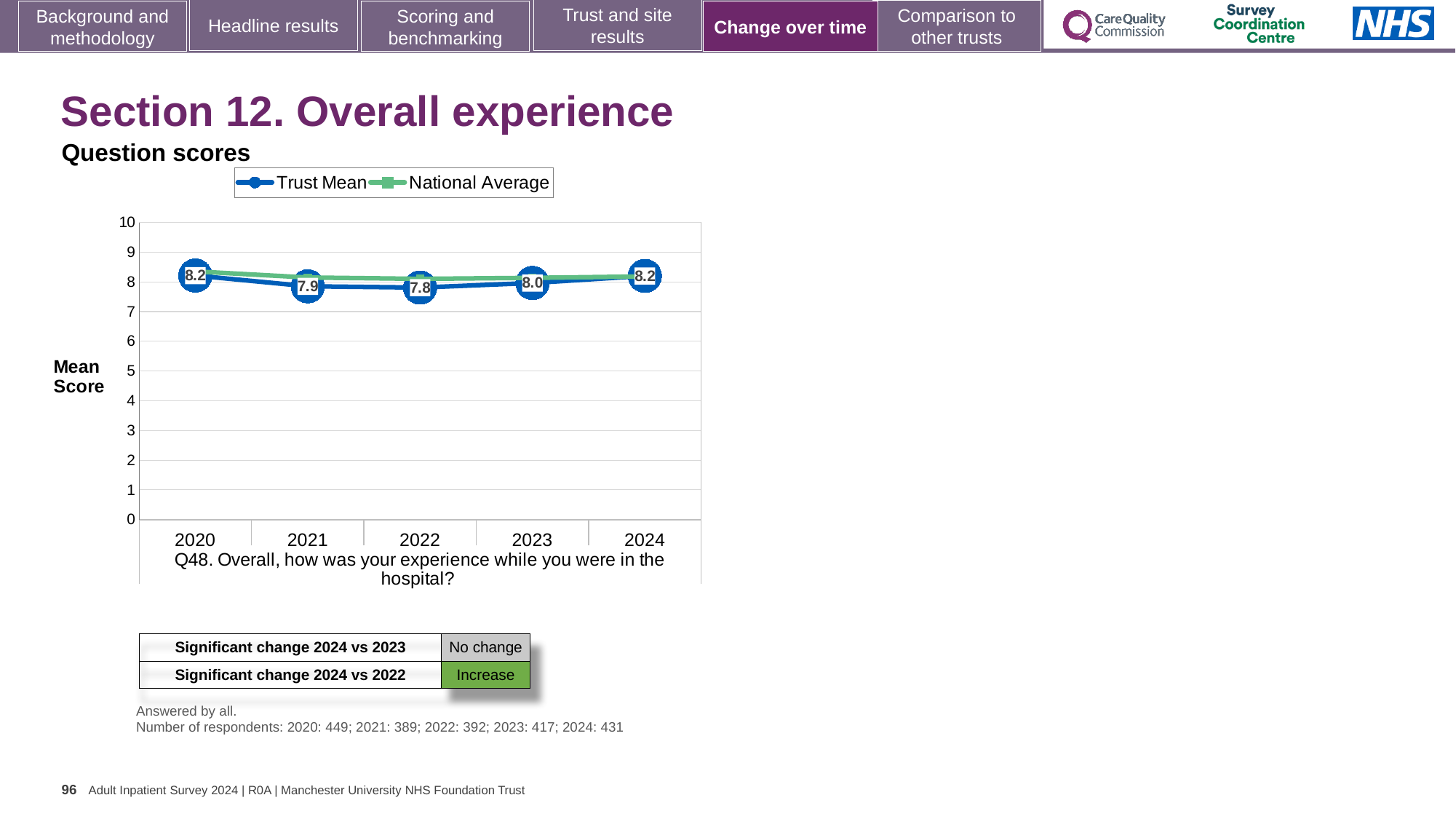
Which is larger, the Trust Mean score in 2021 or in 2023? 2023 Is the National Average value for 2020 greater or less than 8? greater What is the difference between the Trust Mean score in 2024 and in 2022? 0.4 What is the Trust Mean score for 2022? 7.8 Does the Trust Mean score rise or fall from 2022 to 2024? Rise How many series does the chart legend list? 2 What is the label on the y axis of the chart? Mean Score What kind of chart is shown on the slide? Line chart What is the Trust Mean score for 2023? 8.0 In which year is the Trust Mean score lowest? 2022 What is the Trust Mean score for 2020? 8.2 How many years are plotted on the x axis of the chart? 5